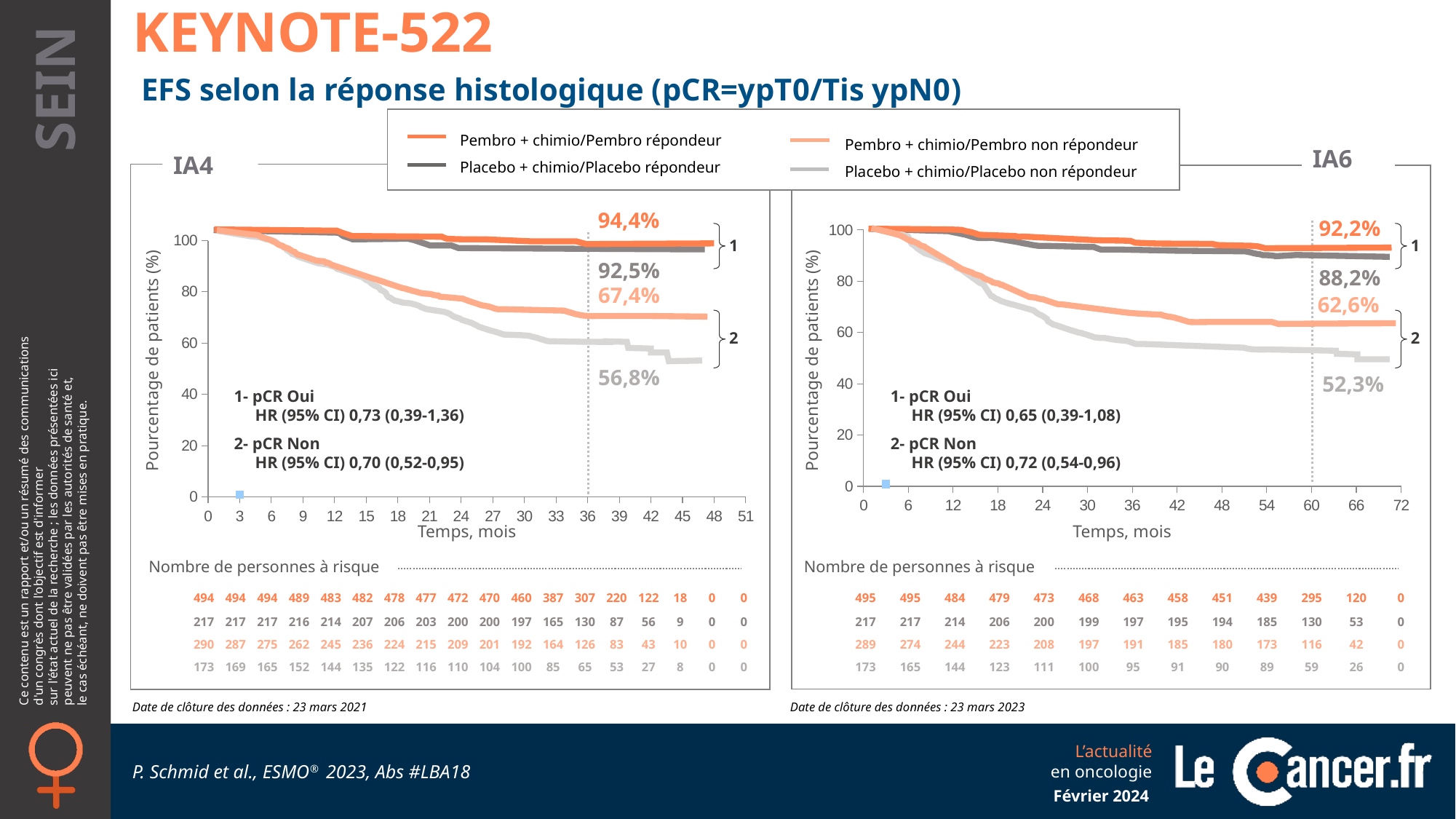
On the IA6 chart, what is the labelled percentage for the Pembro + chimio/Pembro non répondeur group? 62,6% What kind of chart is shown on the IA4 panel? Line chart (Kaplan-Meier survival curve) On the IA4 chart, what is the difference between the labelled percentages of the Pembro non répondeur group (67,4%) and the Placebo non répondeur group (56,8%)? 10,6% On the IA4 chart, how many patients are at risk at time 0 in the Pembro + chimio/Pembro répondeur group? 494 How many series does the legend list? 4 On the IA4 chart, what is the labelled event-free survival percentage for the Pembro + chimio/Pembro répondeur group? 94,4% On the IA6 chart, which group has the highest labelled percentage? Pembro + chimio/Pembro répondeur On the IA6 chart, what is the HR (95% CI) reported for the pCR Non comparison? 0,72 (0,54-0,96) On the IA6 chart, what is the difference between the labelled percentages of the Pembro répondeur group (92,2%) and the Placebo répondeur group (88,2%)? 4,0% On the IA4 chart, which is larger: the labelled percentage for Placebo répondeur or for Pembro non répondeur? Placebo répondeur On the IA6 chart, what is the labelled percentage for the Placebo + chimio/Placebo non répondeur group? 52,3% On the IA4 chart, which group has the lowest labelled percentage? Placebo + chimio/Placebo non répondeur